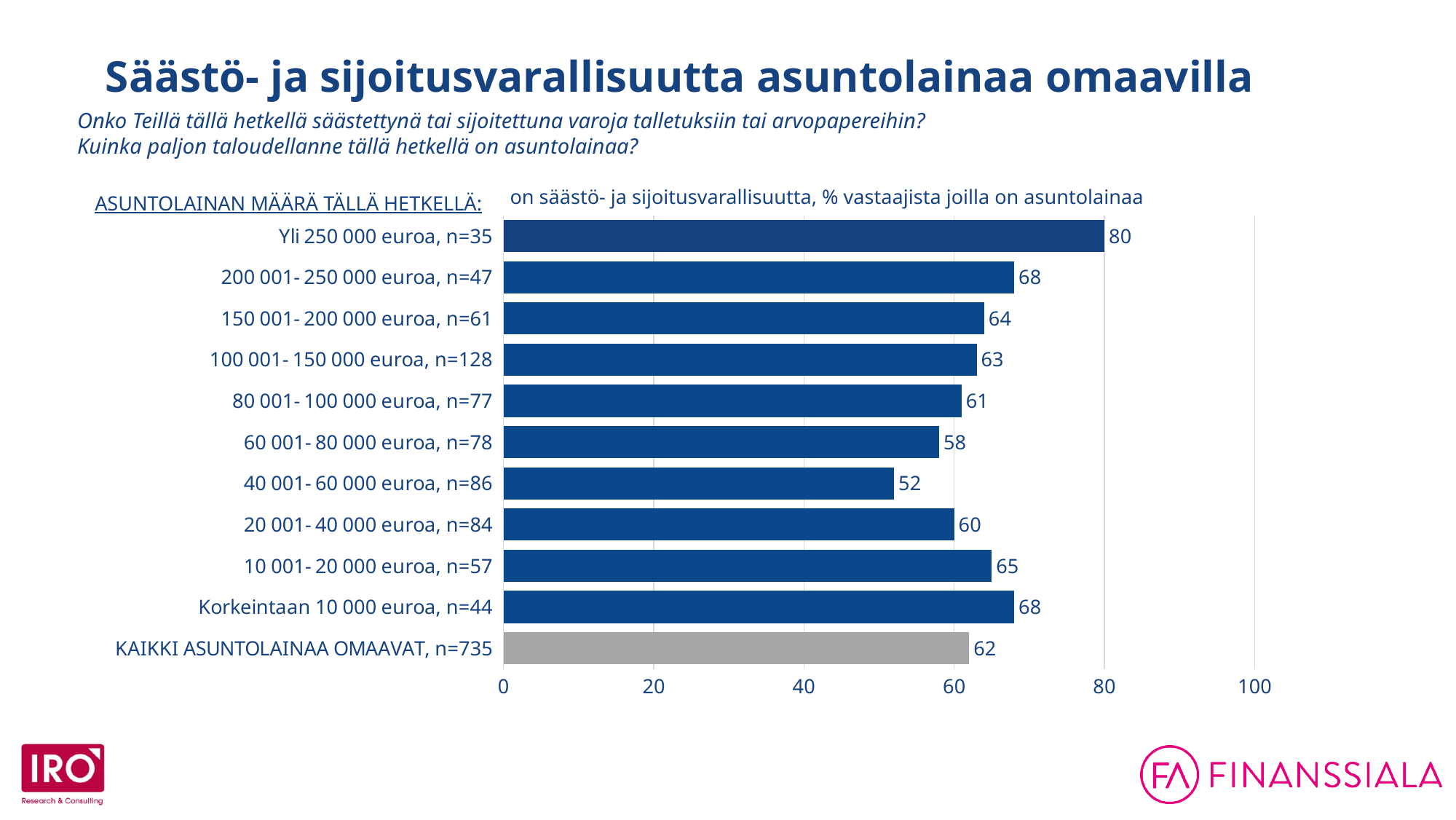
What is the value for 'Yli 250 000 euroa, n=35'? 80 What is the difference between the values for 'Yli 250 000 euroa, n=35' and '40 001- 60 000 euroa, n=86'? 28 What kind of chart is shown on the slide? Bar chart Which is larger, the value for '10 001- 20 000 euroa, n=57' or the value for '20 001- 40 000 euroa, n=84'? 10 001- 20 000 euroa, n=57 Which category has the lowest value? 40 001- 60 000 euroa, n=86 Is the value for '60 001- 80 000 euroa, n=78' greater or less than 60? less What is the difference between the values for '200 001- 250 000 euroa, n=47' and 'KAIKKI ASUNTOLAINAA OMAAVAT, n=735'? 6 Which bar is shown in grey rather than blue? KAIKKI ASUNTOLAINAA OMAAVAT, n=735 Which category has the highest value? Yli 250 000 euroa, n=35 What is the value for 'KAIKKI ASUNTOLAINAA OMAAVAT, n=735'? 62 How many categories (bars) are shown in the chart? 11 What is the value for '40 001- 60 000 euroa, n=86'? 52